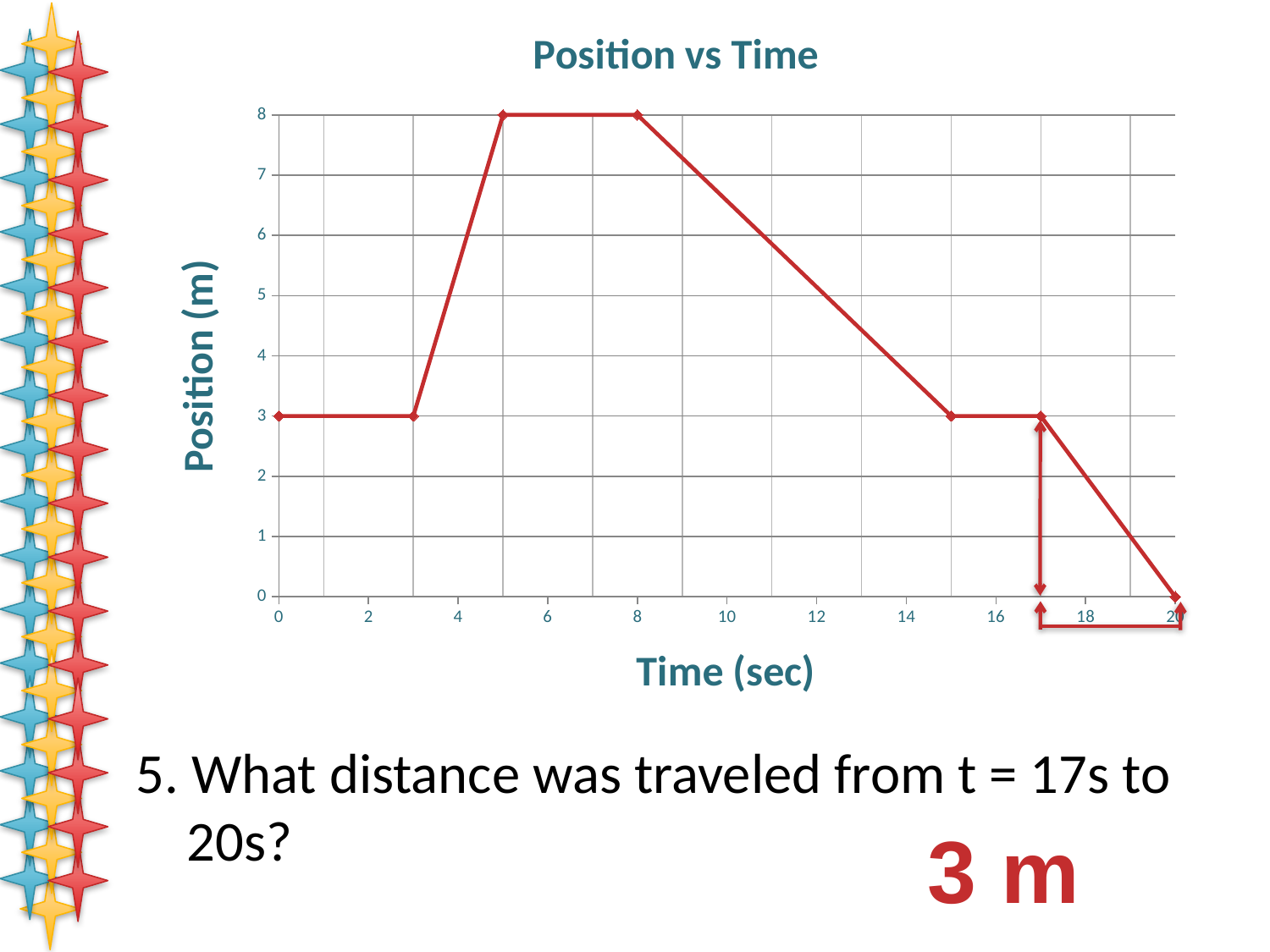
What is the position at t = 20 seconds? 0 What is the highest position value reached on the chart? 8 How many data points are plotted on the line? 7 What is the label of the vertical axis? Position (m) Does the position rise or fall between t = 8 and t = 15 seconds? fall What is the lowest position value on the chart? 0 What is the position at t = 0 seconds? 3 What type of chart is shown on the slide? line chart What is the difference between the position at t = 8 seconds and the position at t = 0 seconds? 5 What is the title of the chart? Position vs Time What is the position at t = 17 seconds? 3 What is the position at t = 8 seconds? 8